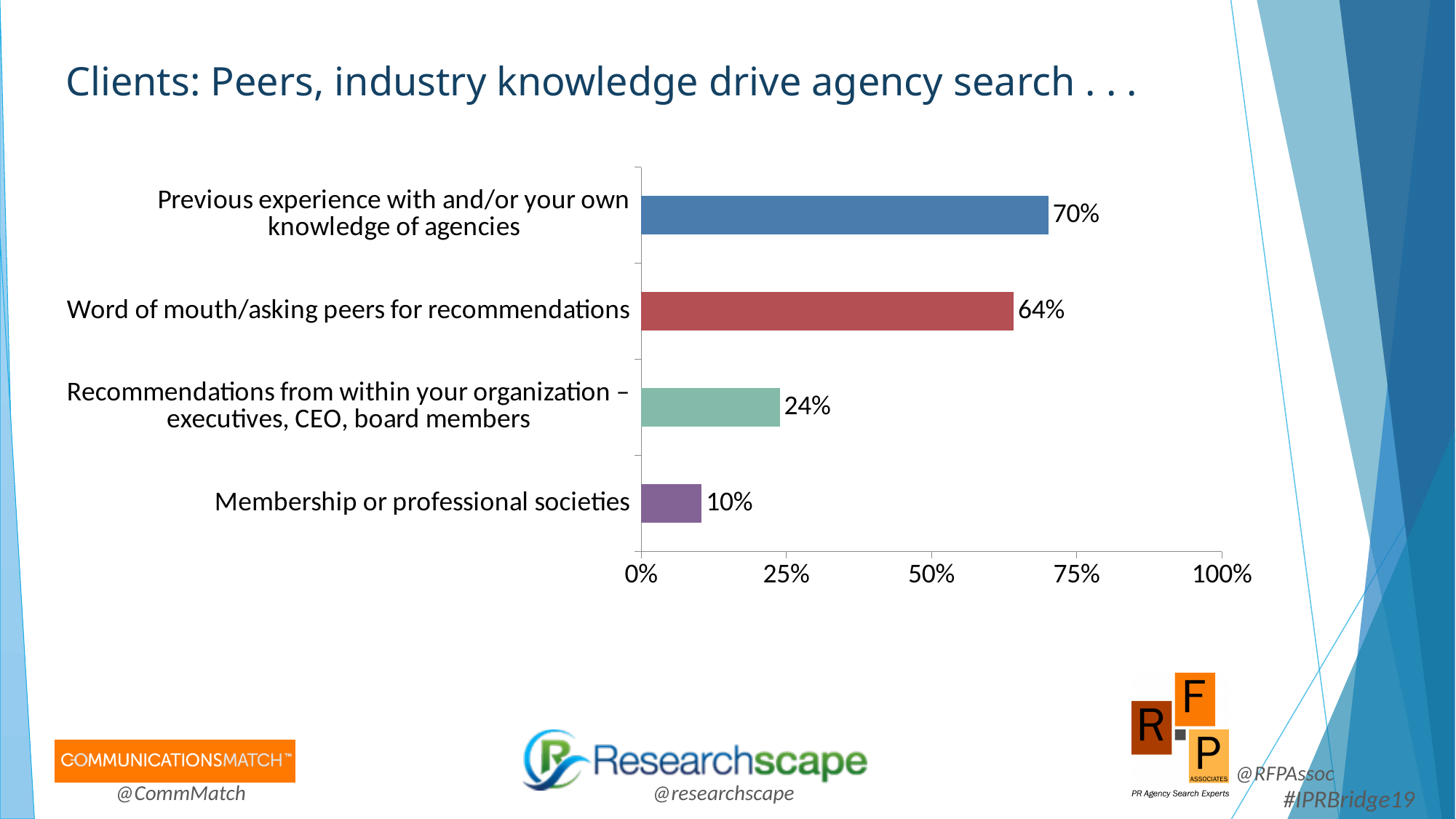
Which is larger: the value for "Word of mouth/asking peers for recommendations" or the value for "Recommendations from within your organization – executives, CEO, board members"? Word of mouth/asking peers for recommendations What is the value for "Word of mouth/asking peers for recommendations"? 64% What is the value for "Membership or professional societies"? 10% What is the difference between the values for "Recommendations from within your organization – executives, CEO, board members" and "Membership or professional societies"? 14% What kind of chart is shown on the slide? Bar chart What is the value for "Previous experience with and/or your own knowledge of agencies"? 70% What is the value for "Recommendations from within your organization – executives, CEO, board members"? 24% How many categories are shown in the chart? 4 Which category has the highest value? Previous experience with and/or your own knowledge of agencies What is the difference between the values for "Previous experience with and/or your own knowledge of agencies" and "Word of mouth/asking peers for recommendations"? 6% Which category has the lowest value? Membership or professional societies Is the value for "Word of mouth/asking peers for recommendations" greater or less than 50%? greater